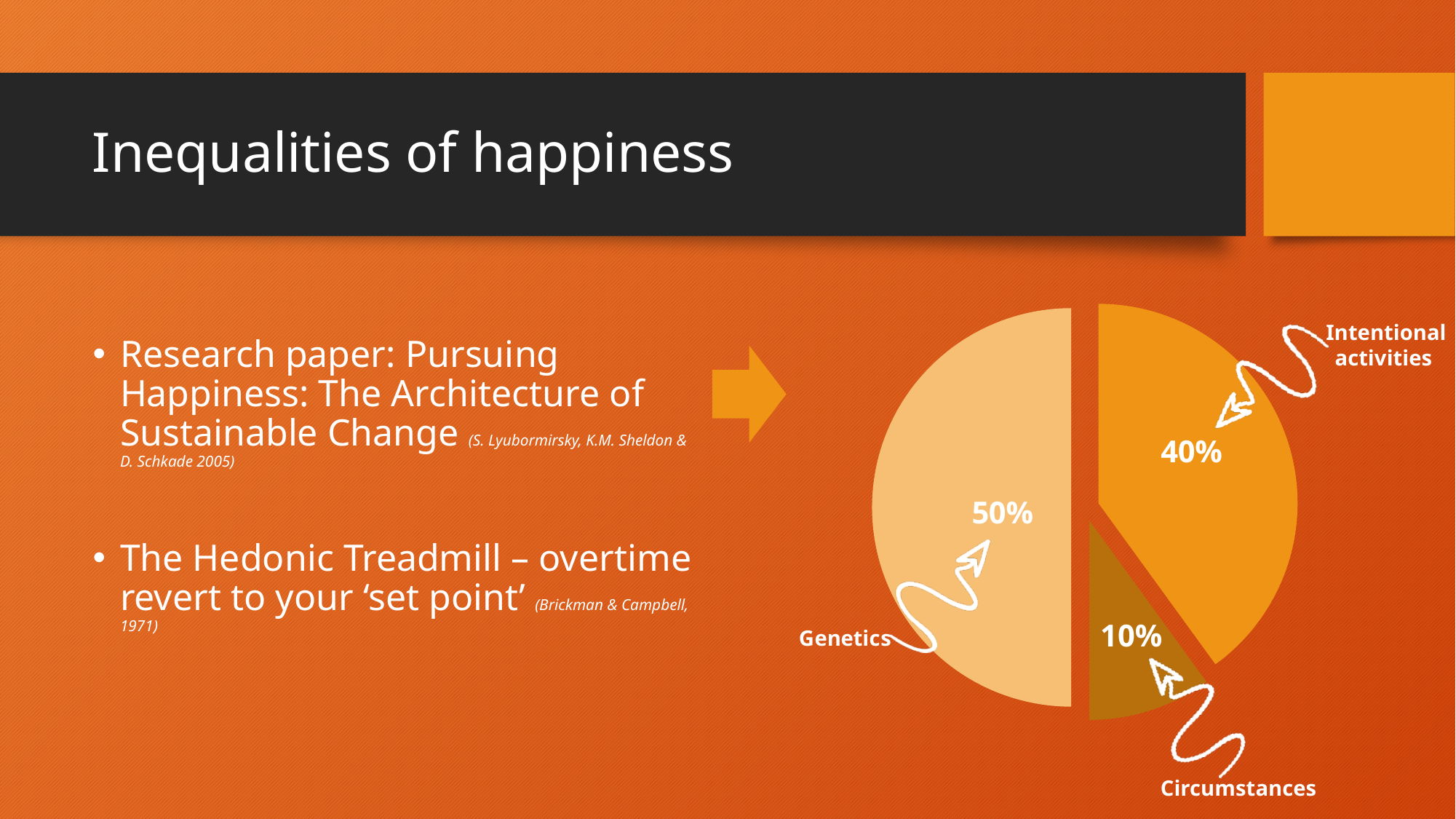
How many slices does the pie chart have? 3 What is the difference between the Intentional activities share and the Circumstances share? 30% Which slice of the pie is the darkest in colour? Circumstances What share of the pie is labelled Circumstances? 10% Which slice of the pie is the largest? Genetics Which is larger, the Intentional activities slice or the Circumstances slice? Intentional activities Which slice of the pie is the smallest? Circumstances What kind of chart is shown on the slide? pie chart What is the difference between the Genetics share and the Intentional activities share? 10% What share of the pie is labelled Genetics? 50% What is the combined share of Intentional activities and Circumstances? 50% What share of the pie is labelled Intentional activities? 40%